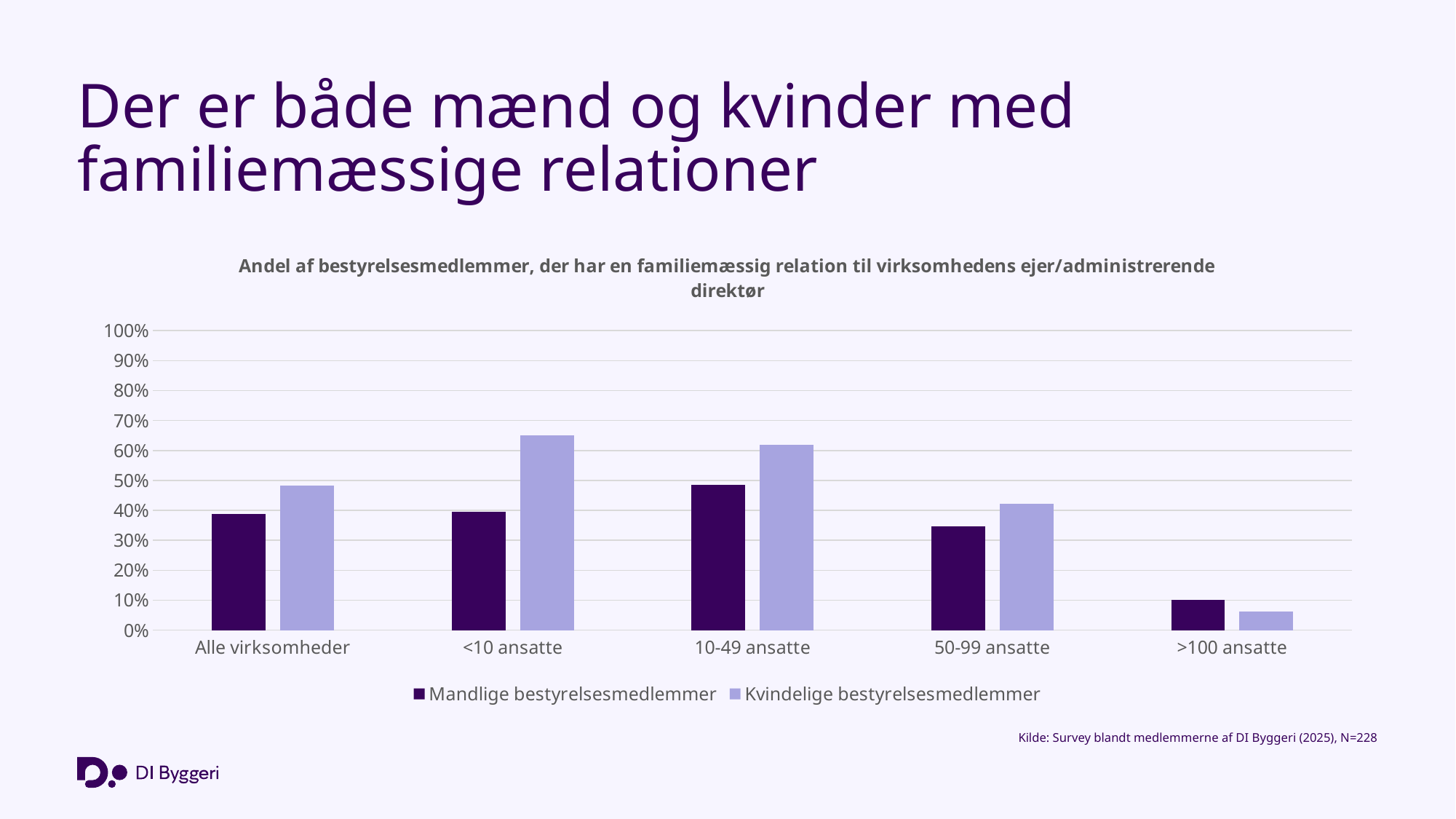
What kind of chart is shown on the slide? bar chart Which category has the highest value for Mandlige bestyrelsesmedlemmer? 10-49 ansatte For >100 ansatte, which series has the larger value: Mandlige bestyrelsesmedlemmer or Kvindelige bestyrelsesmedlemmer? Mandlige bestyrelsesmedlemmer For Alle virksomheder, which series has the larger value: Mandlige bestyrelsesmedlemmer or Kvindelige bestyrelsesmedlemmer? Kvindelige bestyrelsesmedlemmer Which category has the lowest value for Mandlige bestyrelsesmedlemmer? >100 ansatte How many categories are shown on the x axis? 5 How many series does the legend list? 2 Which category has the lowest value for Kvindelige bestyrelsesmedlemmer? >100 ansatte Which series is shown in dark purple in the legend? Mandlige bestyrelsesmedlemmer Is the value for Mandlige bestyrelsesmedlemmer in >100 ansatte greater or less than 20%? less Is the value for Kvindelige bestyrelsesmedlemmer in <10 ansatte greater or less than 60%? greater Is the value for Mandlige bestyrelsesmedlemmer in 10-49 ansatte greater or less than 40%? greater